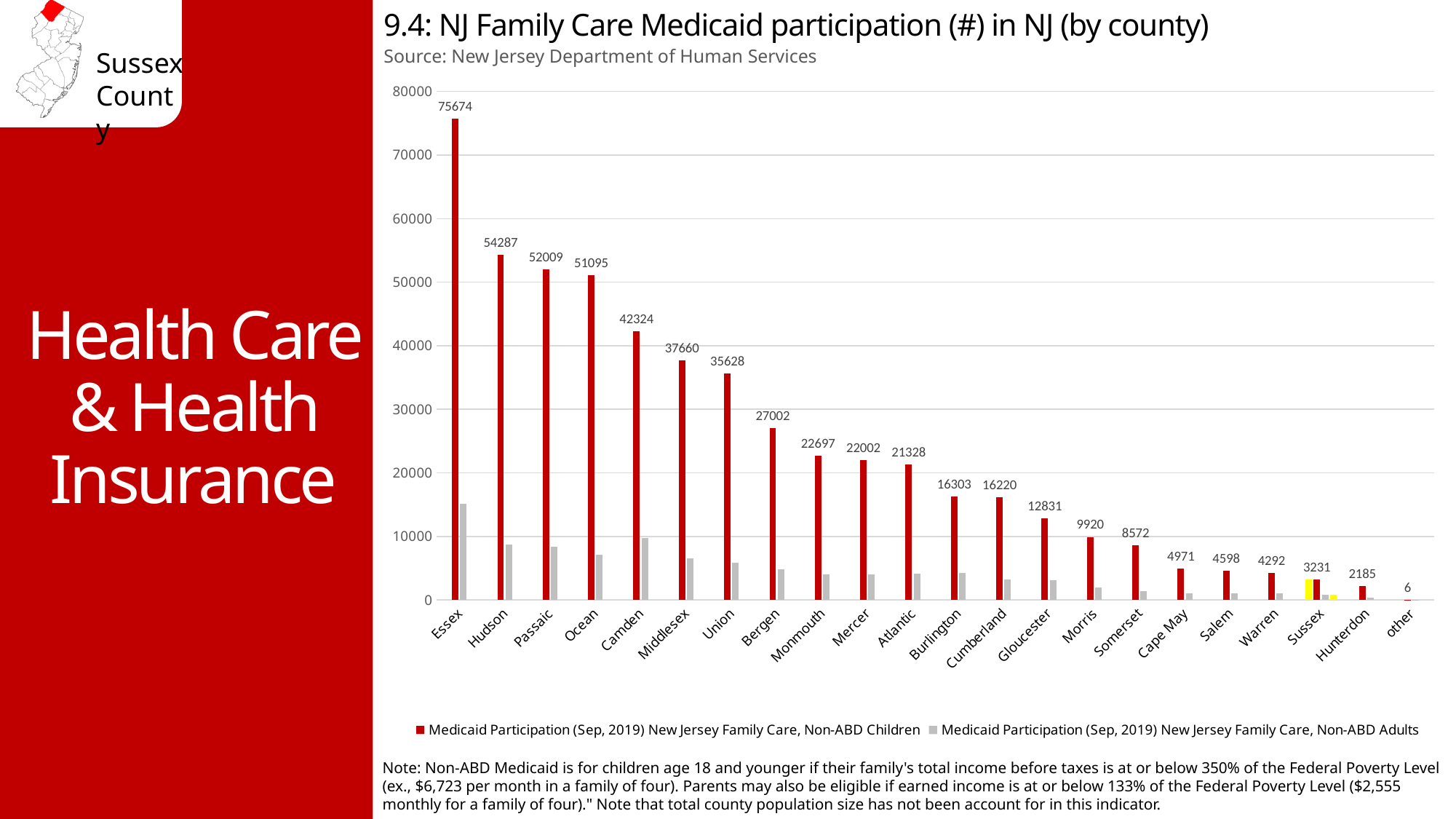
Is the Non-ABD Adults Medicaid participation value for Essex greater or less than 10000? greater What is the Non-ABD Children Medicaid participation value for Essex County? 75674 Is the Non-ABD Adults Medicaid participation value for Hudson greater or less than 10000? less Which has a larger Non-ABD Children Medicaid participation, Bergen or Monmouth? Bergen What is the difference in Non-ABD Children Medicaid participation between Hudson and Passaic? 2278 What is the Non-ABD Children Medicaid participation value for Morris County? 9920 Which county has the highest Non-ABD Children Medicaid participation? Essex How many series does the legend list? 2 Which county has the lowest Non-ABD Children Medicaid participation (excluding 'other')? Hunterdon How many categories are shown on the x axis of the chart? 22 What is the Non-ABD Children Medicaid participation value for Sussex County? 3231 What type of chart is shown on the slide? Bar chart